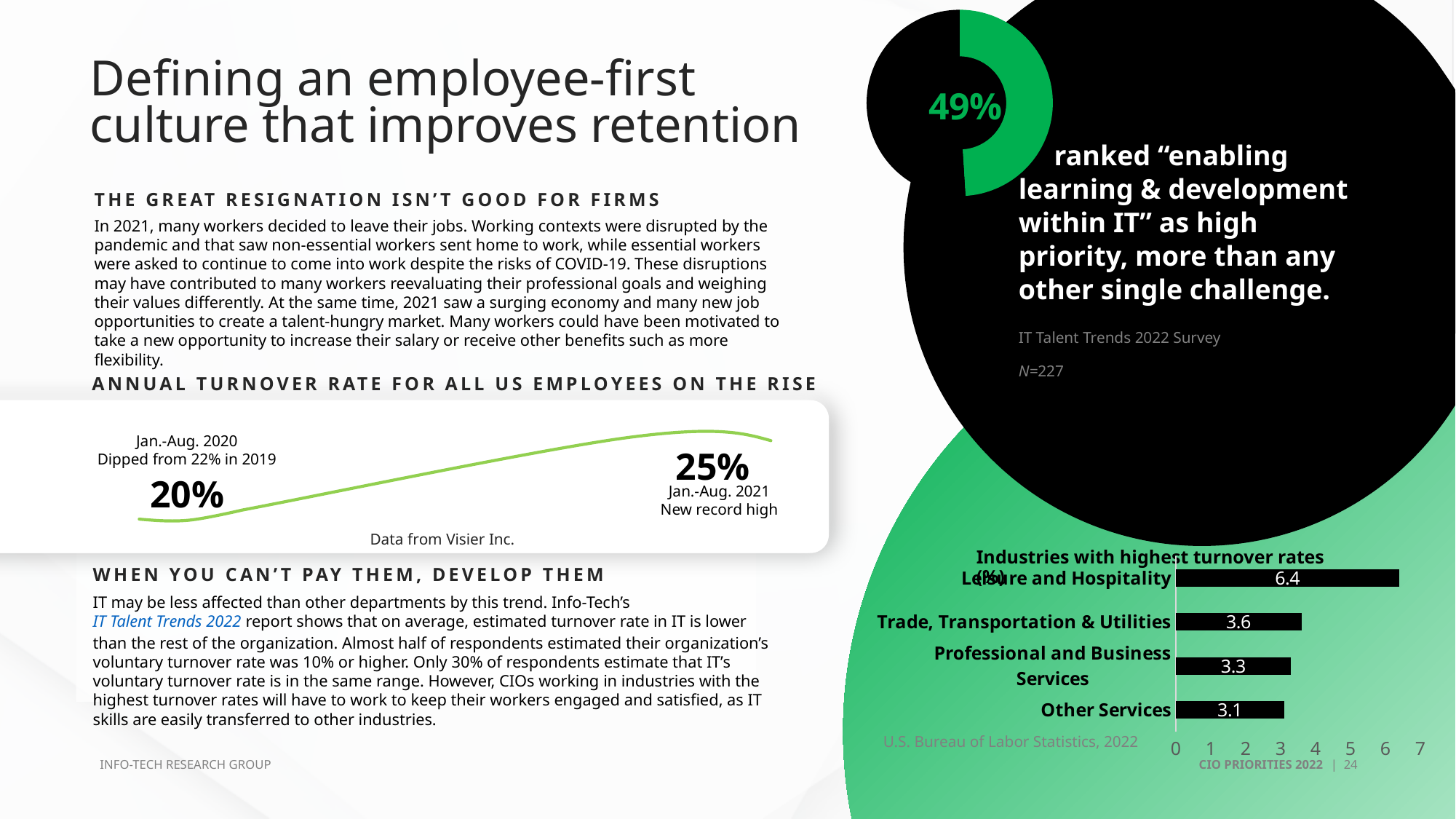
What percentage is shown in the donut chart at the top right of the slide? 49% In the 'Industries with highest turnover rates (%)' bar chart, what is the difference between Leisure and Hospitality and Other Services? 3.3 In the 'Annual turnover rate for all US employees on the rise' line chart, what is the turnover rate for Jan.-Aug. 2021? 25% In the 'Industries with highest turnover rates (%)' bar chart, which is larger: Trade, Transportation & Utilities or Professional and Business Services? Trade, Transportation & Utilities In the 'Industries with highest turnover rates (%)' bar chart, which industry has the highest turnover rate? Leisure and Hospitality In the 'Industries with highest turnover rates (%)' bar chart, what is the value for Leisure and Hospitality? 6.4 In the 'Industries with highest turnover rates (%)' bar chart, what is the value for Professional and Business Services? 3.3 In the 'Annual turnover rate for all US employees on the rise' line chart, does the turnover rate rise or fall from Jan.-Aug. 2020 to Jan.-Aug. 2021? Rise In the 'Industries with highest turnover rates (%)' bar chart, which industry has the lowest turnover rate? Other Services In the 'Industries with highest turnover rates (%)' bar chart, what is the value for Trade, Transportation & Utilities? 3.6 What kind of chart is 'Industries with highest turnover rates (%)'? Bar chart How many industries are shown in the 'Industries with highest turnover rates (%)' bar chart? 4